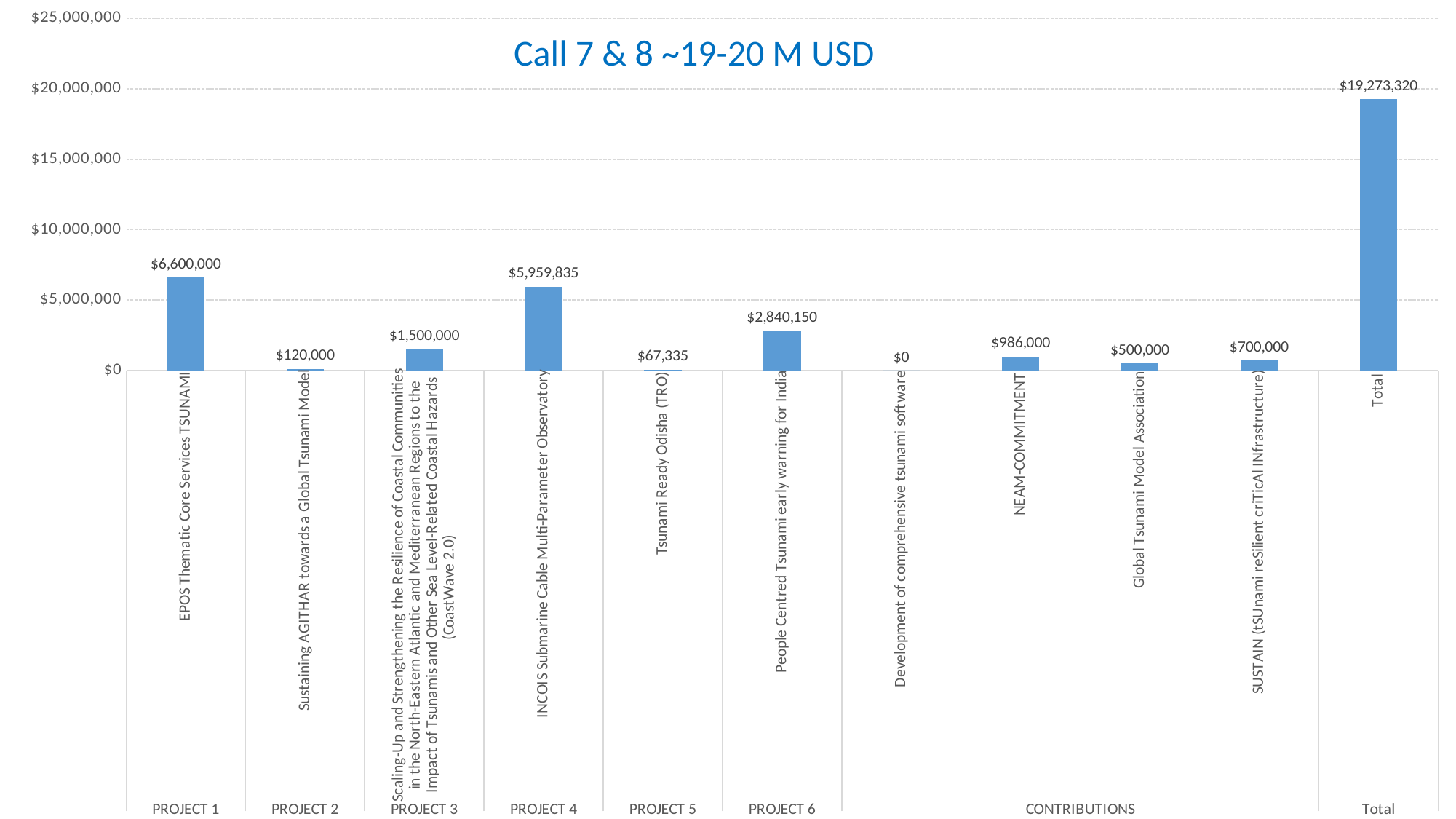
Which is larger: the value for People Centred Tsunami early warning for India or the value for Scaling-Up and Strengthening the Resilience of Coastal Communities (CoastWave 2.0)? People Centred Tsunami early warning for India How many bars are plotted on the chart, including the Total bar? 11 What is the value shown for the Total bar? $19,273,320 What is the difference between the values for EPOS Thematic Core Services TSUNAMI and INCOIS Submarine Cable Multi-Parameter Observatory? $640,165 What kind of chart is shown on the slide? Bar chart What is the value for INCOIS Submarine Cable Multi-Parameter Observatory? $5,959,835 What is the title of the chart? Call 7 & 8 ~19-20 M USD What is the value for EPOS Thematic Core Services TSUNAMI? $6,600,000 Which category has the lowest value? Development of comprehensive tsunami software What is the value for NEAM-COMMITMENT? $986,000 What is the value for Tsunami Ready Odisha (TRO)? $67,335 Excluding the Total bar, which category has the highest value? EPOS Thematic Core Services TSUNAMI